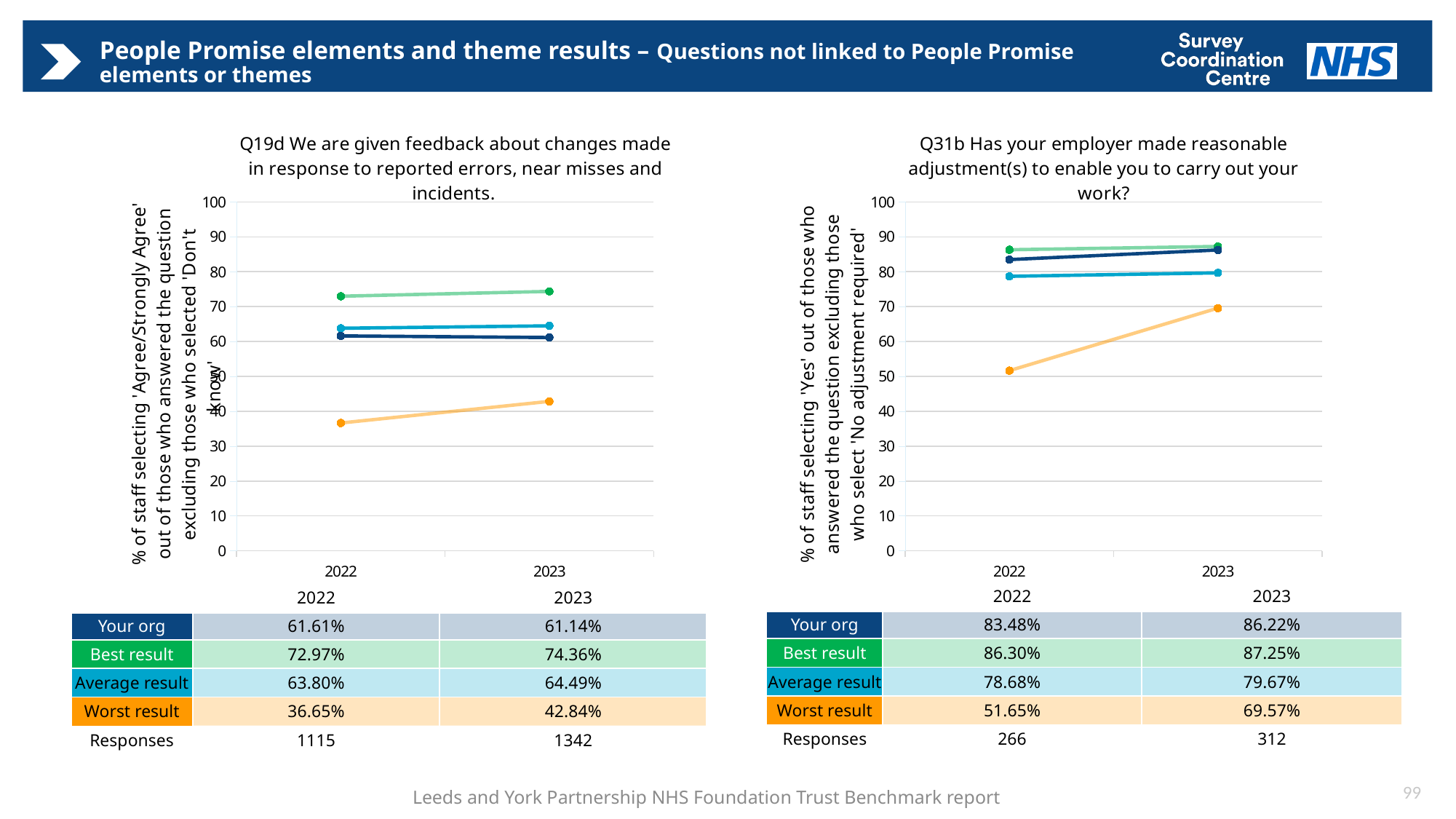
On the Q19d chart, which is larger: the Average result in 2023 or Your org in 2023? Average result in 2023 On the Q31b chart, what is the Average result value in 2022? 78.68% On the Q31b chart, does the Worst result line rise or fall from 2022 to 2023? rise How many years are plotted on the x axis of the Q19d chart? 2 On the Q19d chart, what is the value for Your org in 2023? 61.14% On the Q31b chart, by how many percentage points did the Worst result increase from 2022 to 2023? 17.92 On the Q19d chart, what is the Worst result value in 2022? 36.65% On the Q31b chart, what is the Best result value in 2023? 87.25% On the Q19d chart, which series has the lowest value in 2023? Worst result On the Q31b chart, which series has the highest value in 2022? Best result On the Q31b chart, is the Worst result value for 2022 greater or less than 60? less What kind of chart is the Q31b chart? line chart